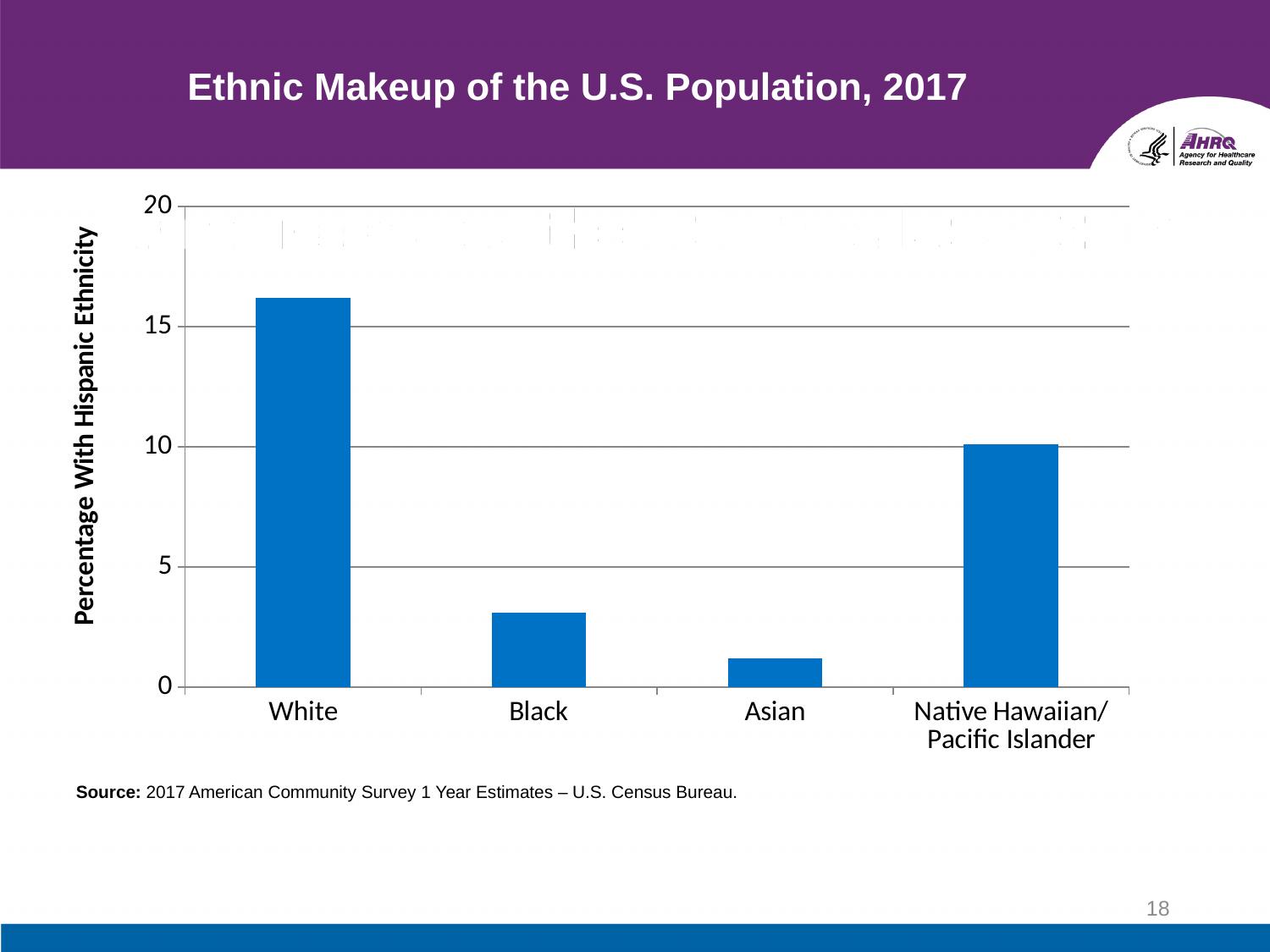
Is the value for White greater or less than 15? greater Is the value for Asian greater or less than 5? less Which category has the highest percentage with Hispanic ethnicity? White Is the value for Native Hawaiian/Pacific Islander greater or less than 5? greater What is the label on the vertical axis of the chart? Percentage With Hispanic Ethnicity Which category has the lowest percentage with Hispanic ethnicity? Asian Which has a higher percentage with Hispanic ethnicity, Native Hawaiian/Pacific Islander or Black? Native Hawaiian/Pacific Islander What kind of chart is shown on the slide? bar chart Which has a higher percentage with Hispanic ethnicity, Black or Asian? Black How many ethnic categories are plotted on the chart? 4